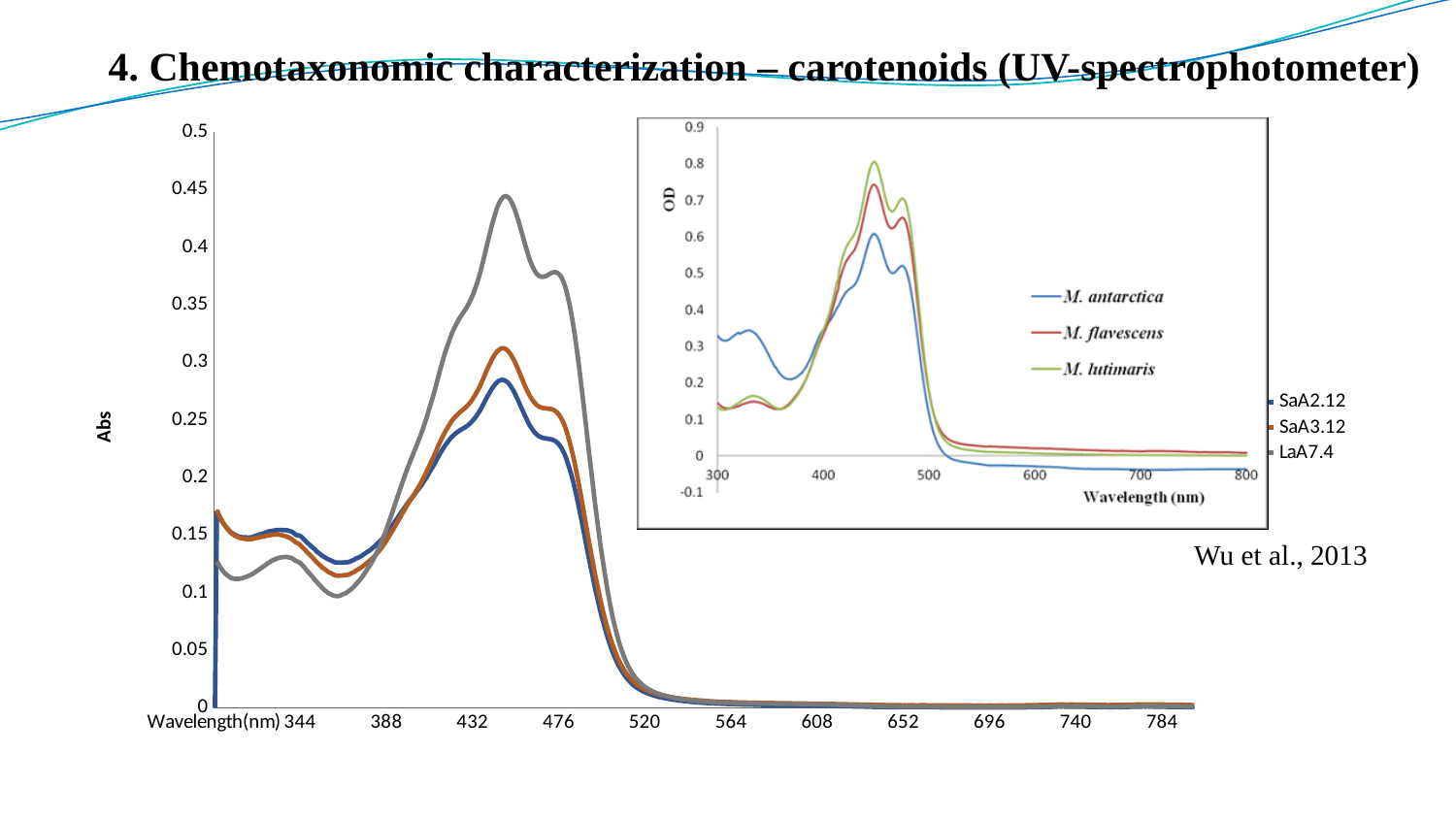
On the inset chart on the right (Wu et al., 2013), how many series does the legend list? 3 On the large chart on the left, what kind of chart is shown? line chart On the inset chart on the right (Wu et al., 2013), which species reaches the highest OD peak? M. lutimaris On the large chart on the left, which series has the lowest absorbance peak? SaA2.12 On the large chart on the left, which series reaches the highest absorbance peak? LaA7.4 On the large chart on the left, do the absorbance values rise or fall between 476 nm and 520 nm? fall On the large chart on the left, how many series does the legend list? 3 On the large chart on the left, what is the label of the y axis? Abs On the large chart on the left, which series has the higher peak, SaA3.12 or SaA2.12? SaA3.12 On the large chart on the left, is the peak value for SaA2.12 greater or less than 0.3? less On the inset chart on the right (Wu et al., 2013), is the peak OD for M. antarctica greater or less than 0.7? less On the large chart on the left, is the peak value for LaA7.4 greater or less than 0.4? greater